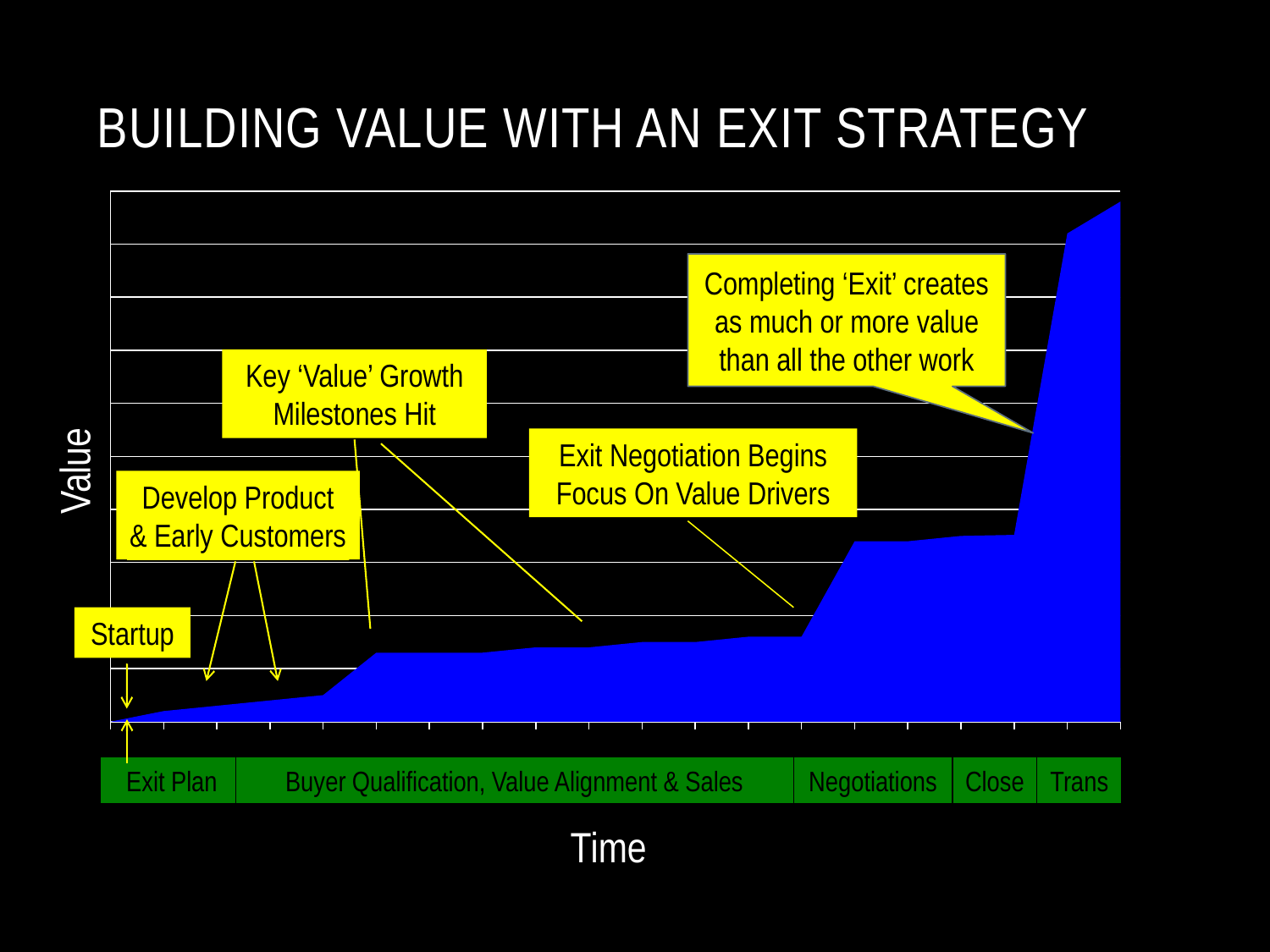
What kind of chart is shown on the slide? Area chart How many phases are labelled in the green band along the bottom of the chart? 5 In which phase along the bottom of the chart is the value at its lowest? Exit Plan Is the value higher during the Close phase or during the Trans phase? Trans Is the value higher during the Negotiations phase or during the Buyer Qualification, Value Alignment & Sales phase? Negotiations In which phase along the bottom of the chart does the value reach its highest point? Trans Does the plotted value rise or fall as time moves from left to right along the x axis? Rises What is the title of the slide? BUILDING VALUE WITH AN EXIT STRATEGY What label is shown on the vertical axis of the chart? Value